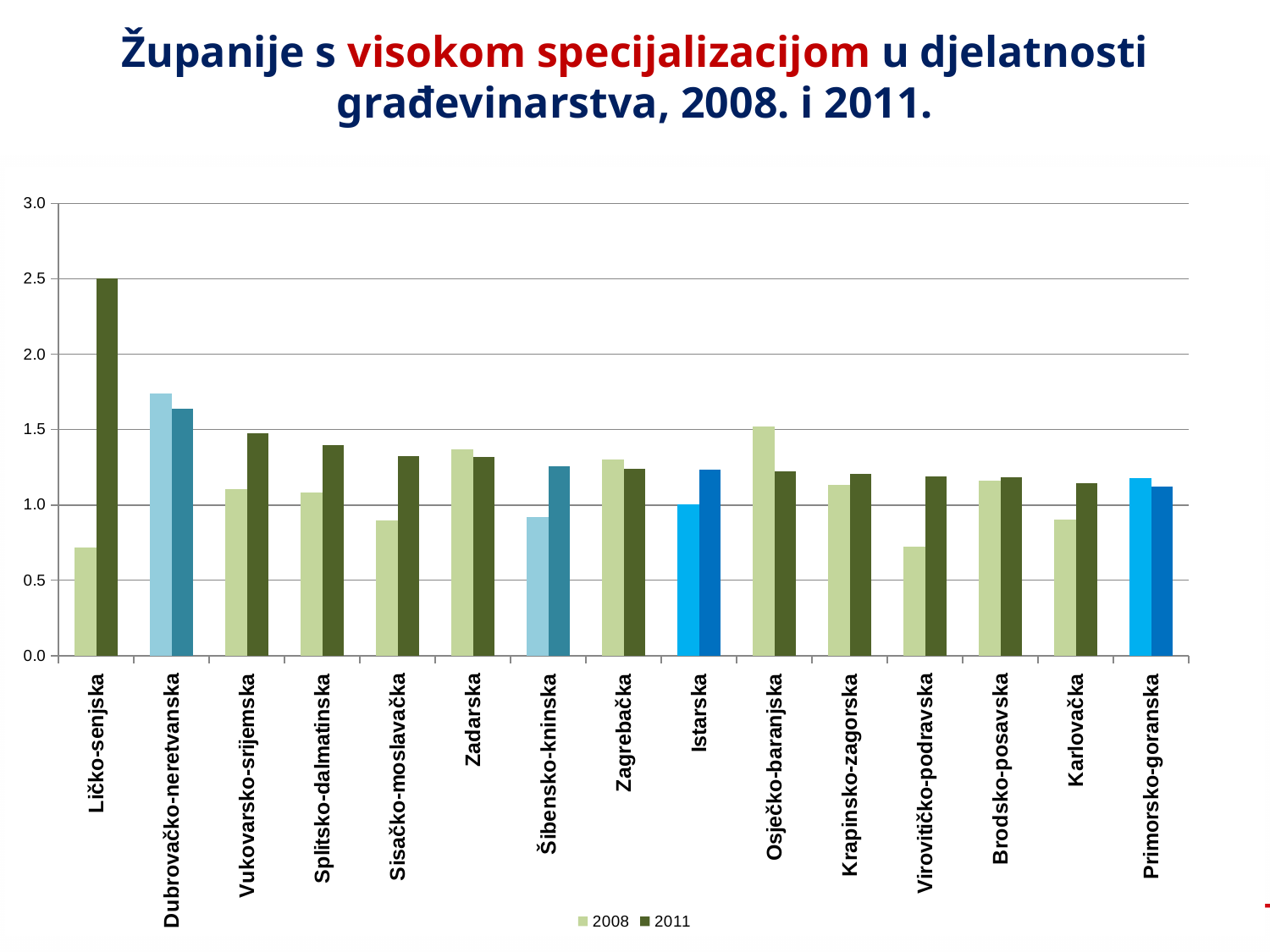
Is the 2011 value for Ličko-senjska greater or less than 2.0? greater For Osječko-baranjska, which year has the larger value, 2008 or 2011? 2008 What kind of chart is shown on the slide? bar chart Do the 2011 values generally rise or fall from left to right across the counties? fall For Ličko-senjska, which year has the larger value, 2008 or 2011? 2011 Is the 2008 value for Karlovačka greater or less than 1.0? less Which county has the highest 2011 value? Ličko-senjska Is the 2008 value for Dubrovačko-neretvanska greater or less than 1.5? greater How many series does the legend list? 2 How many counties (categories) are shown on the x axis? 15 Which county has the highest 2008 value? Dubrovačko-neretvanska